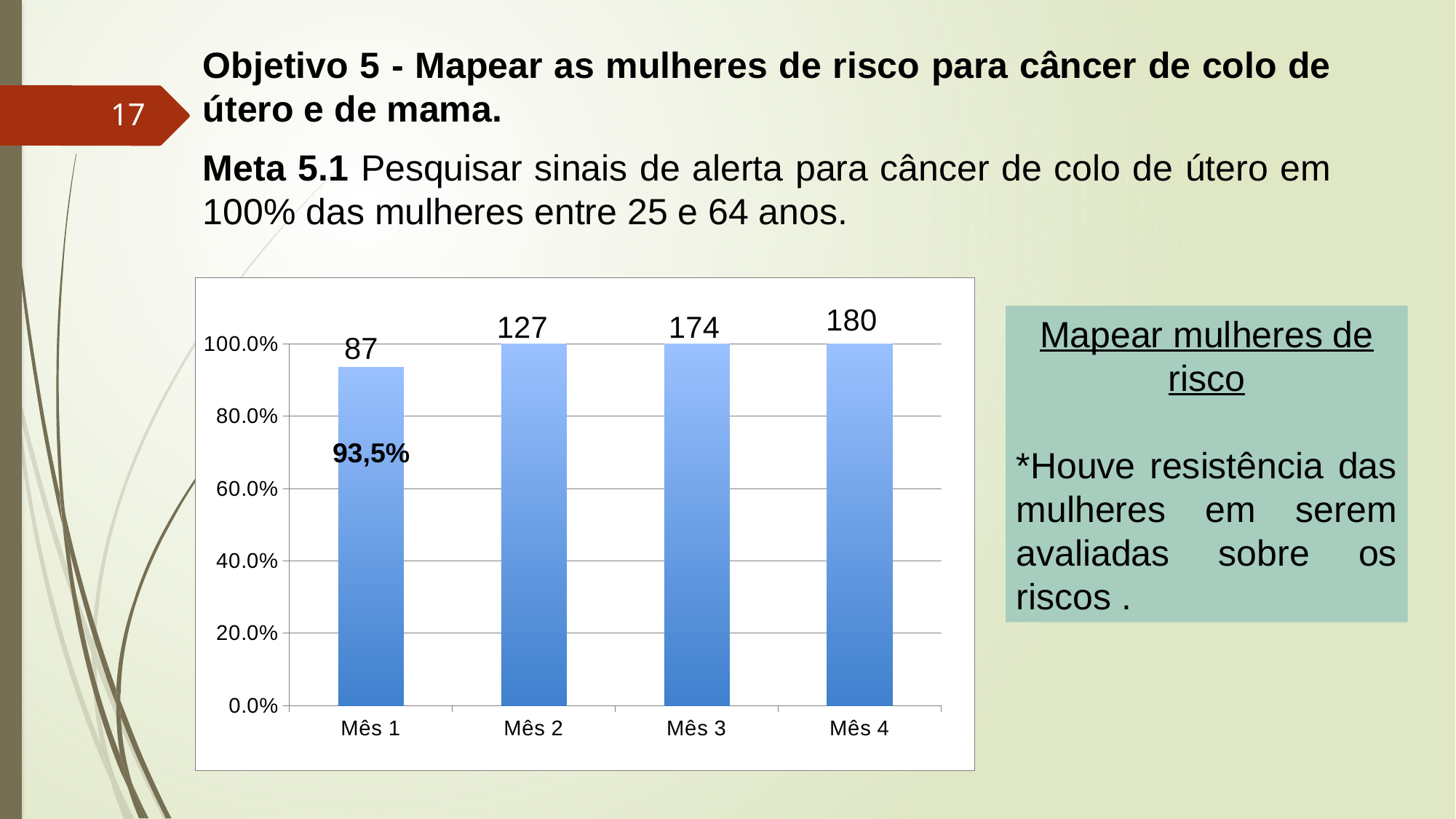
Is the bar for Mês 1 greater or less than 80.0%? greater Which month has the lowest bar in the chart? Mês 1 How many categories (months) are shown on the x axis of the chart? 4 What number is printed above the bar for Mês 4? 180 What number is printed above the bar for Mês 1? 87 Which bar is taller, Mês 1 or Mês 2? Mês 2 Do the numbers printed above the bars rise or fall from Mês 1 to Mês 4? rise What kind of chart is shown on the slide? bar chart What number is printed above the bar for Mês 3? 174 What percentage is printed on the bar for Mês 1? 93,5% What is the difference between the numbers printed above the bars for Mês 4 and Mês 1? 93 What number is printed above the bar for Mês 2? 127